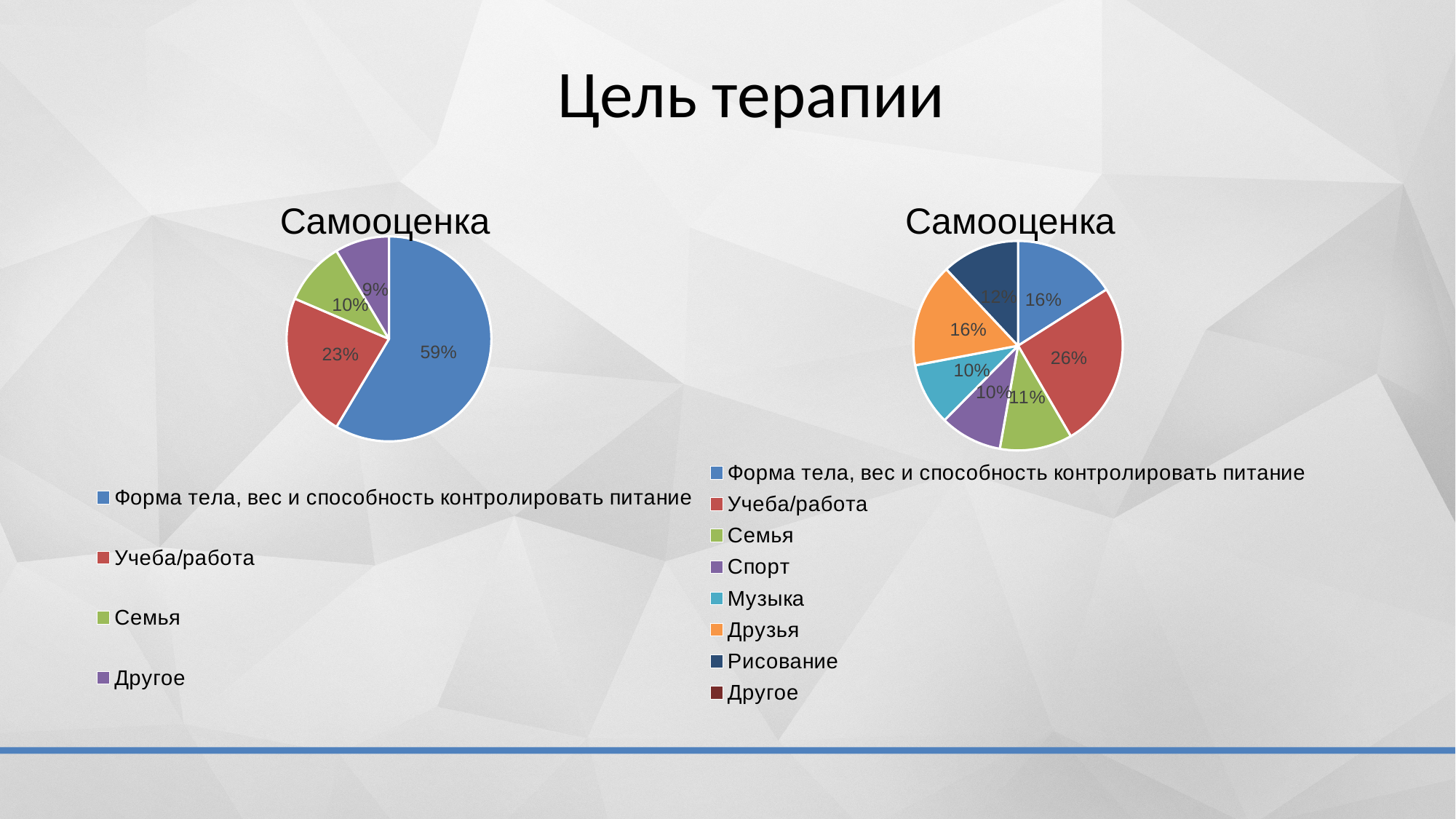
On the left pie chart, what is the value for Учеба/работа? 23% On the right pie chart, what is the value for Учеба/работа? 26% What type of chart is shown on the left side of the slide? Pie chart How many categories does the legend of the left pie chart list? 4 How many entries does the legend of the right pie chart list? 8 On the right pie chart, which category has the largest slice? Учеба/работа On the left pie chart, which category has the smallest slice? Другое On the left pie chart, what is the difference between Форма тела, вес и способность контролировать питание and Учеба/работа? 36% On the left pie chart, what share does Форма тела, вес и способность контролировать питание have? 59% On the right pie chart, what is the difference between Учеба/работа and Спорт? 16% On the right pie chart, which is larger: Друзья or Семья? Друзья On the right pie chart, what share does Рисование have? 12%